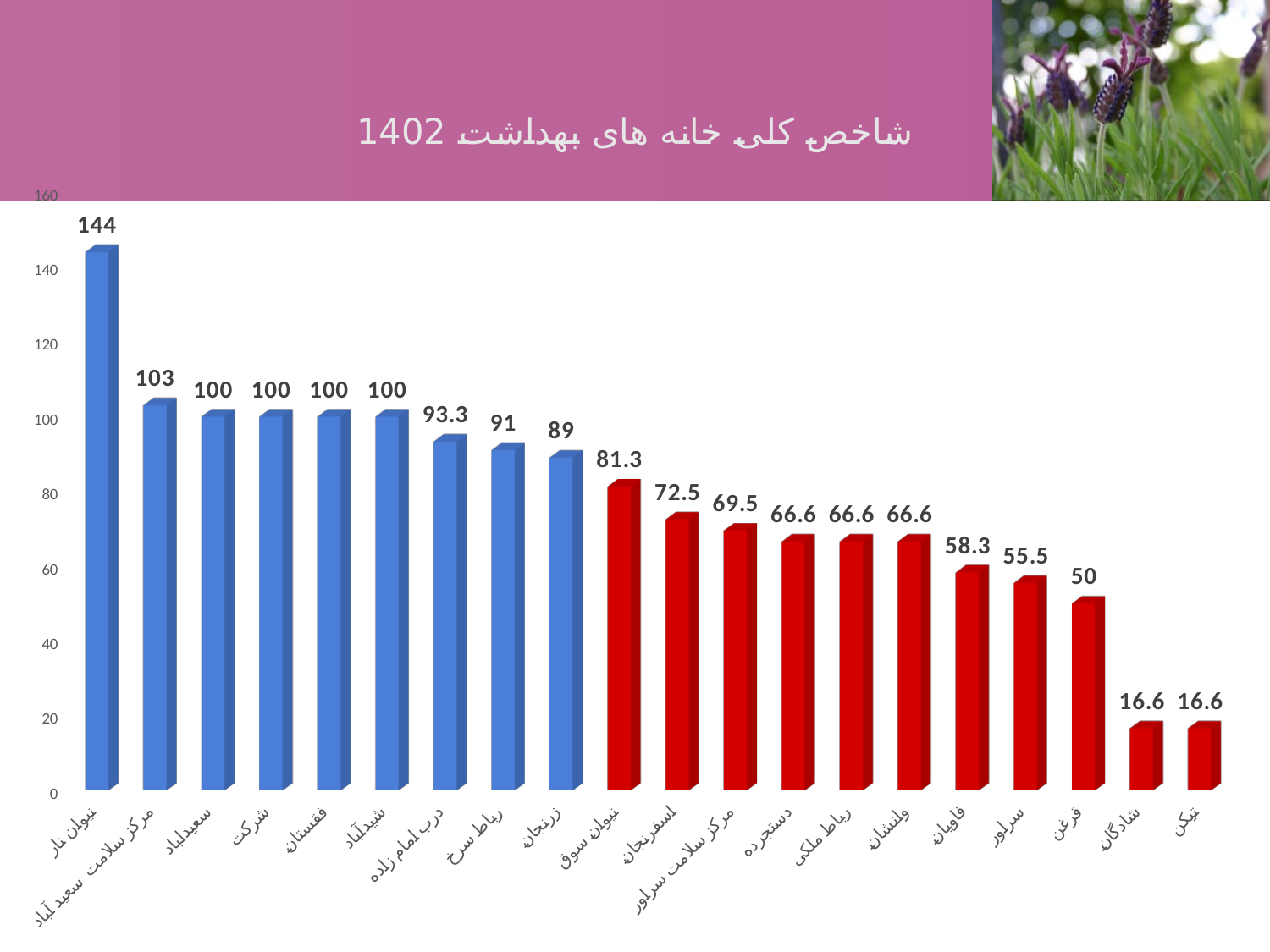
What is the value for درب امام زاده? 93.3 What is the title of the chart? شاخص کلی خانه های بهداشت 1402 Do the values rise or fall from left to right along the x axis? Fall What is the value for فاویان? 58.3 What is the difference between the values for نیوان نار and مرکز سلامت سعیدآباد? 41 Which category has the highest value? نیوان نار What kind of chart is shown on the slide? Bar chart Which is larger, the value for زرنجان or the value for نیوان سوق? زرنجان What is the lowest value shown on the chart? 16.6 What is the value for اسفرنجان? 72.5 How many bars are shown on the chart? 20 What is the value for نیوان نار? 144